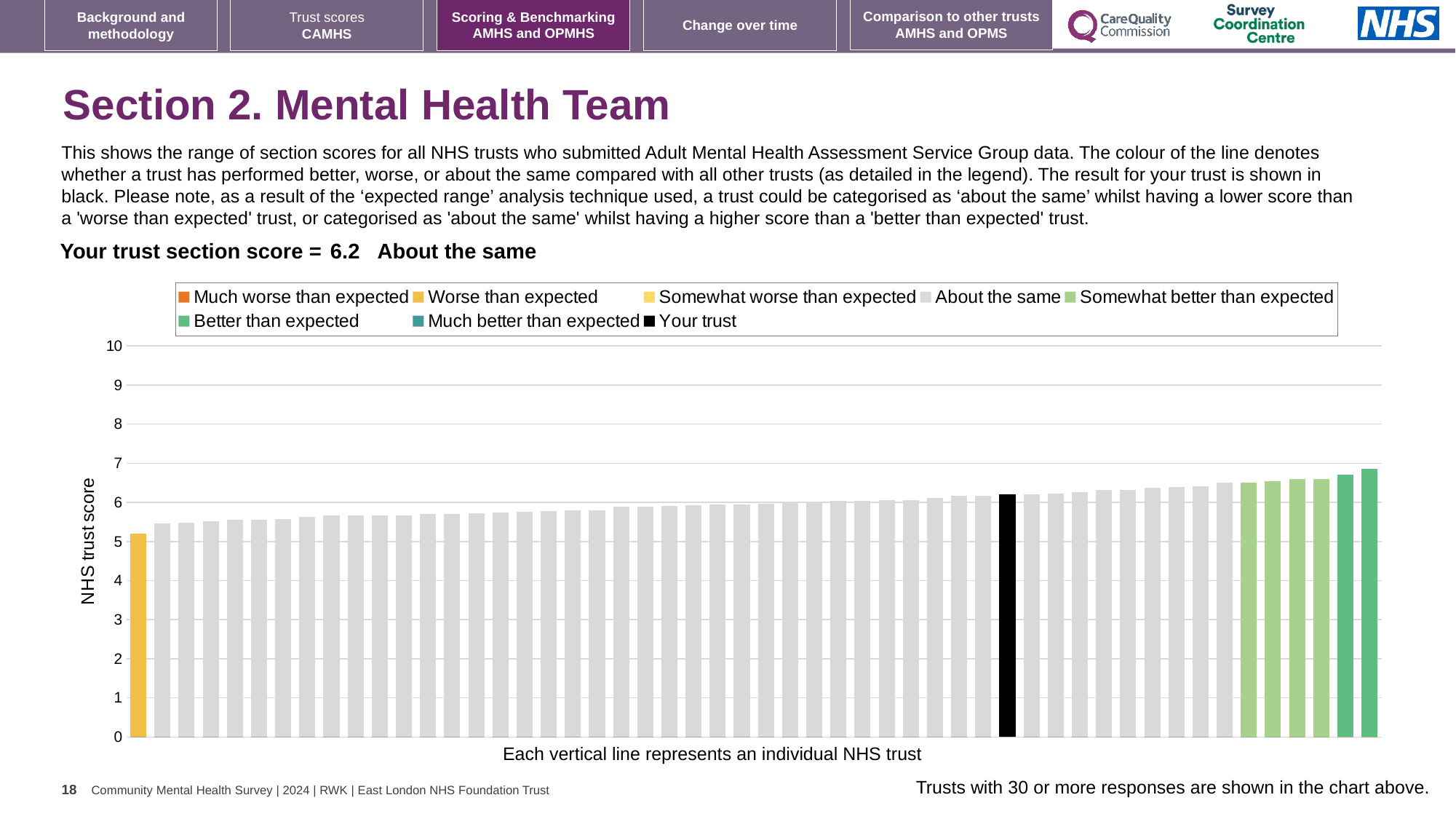
What is the section score for your trust shown on the slide? 6.2 Is the value of the leftmost (yellow) bar greater or less than 6? less How many entries does the chart legend list? 8 Is the value of the rightmost bar greater or less than 7? less What is the label on the vertical axis of the chart? NHS trust score Which performance category is your trust placed in? About the same Is the value for your trust greater or less than 5? greater How many bars are coloured as 'Worse than expected'? 1 Do the bar values rise or fall from left to right along the x axis? rise What kind of chart is shown on the slide? bar chart Is the leftmost bar higher or lower than the black 'Your trust' bar? lower Which legend category does the highest bar in the chart belong to? Better than expected